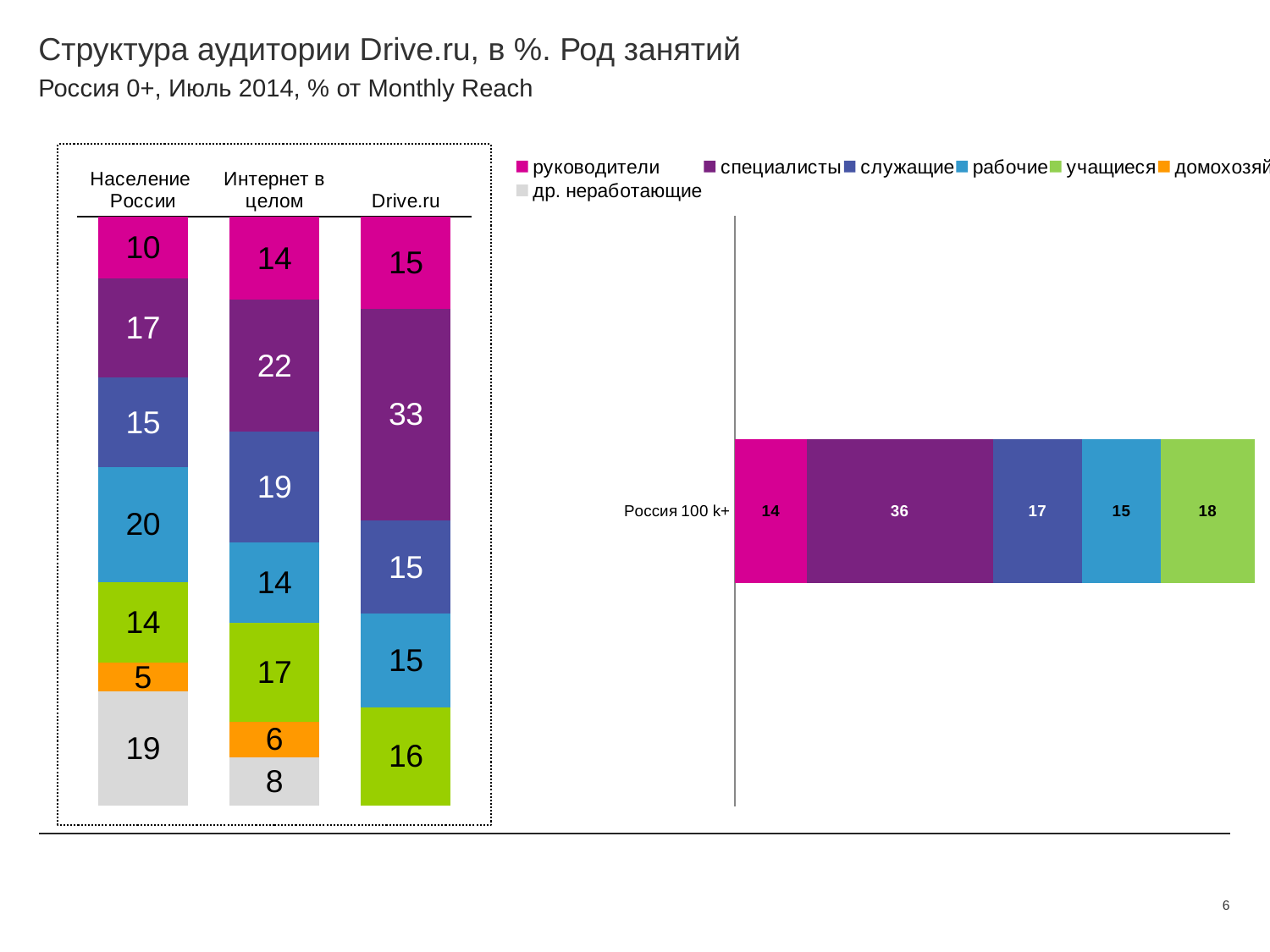
In the left chart, what is the difference between the специалисты values for Drive.ru and Интернет в целом? 11 In the left chart, what is the value for учащиеся in the Интернет в целом bar? 17 What type of chart is the right chart? Stacked bar chart In the left chart, what is the value for рабочие in the Население России bar? 20 In the left chart, which is larger: руководители for Население России or руководители for Drive.ru? Drive.ru In the left chart, how many bars (audience groups) are shown? 3 In the right chart, which segment is the smallest in the Россия 100 k+ bar? руководители In the left chart, which segment is the largest in the Drive.ru bar? специалисты In the right chart, what is the total of the Россия 100 k+ bar? 100 In the left chart, what is the value for специалисты in the Drive.ru bar? 33 In the right chart, what is the value for специалисты in the Россия 100 k+ bar? 36 In the left chart, what is the total of the Население России bar? 100